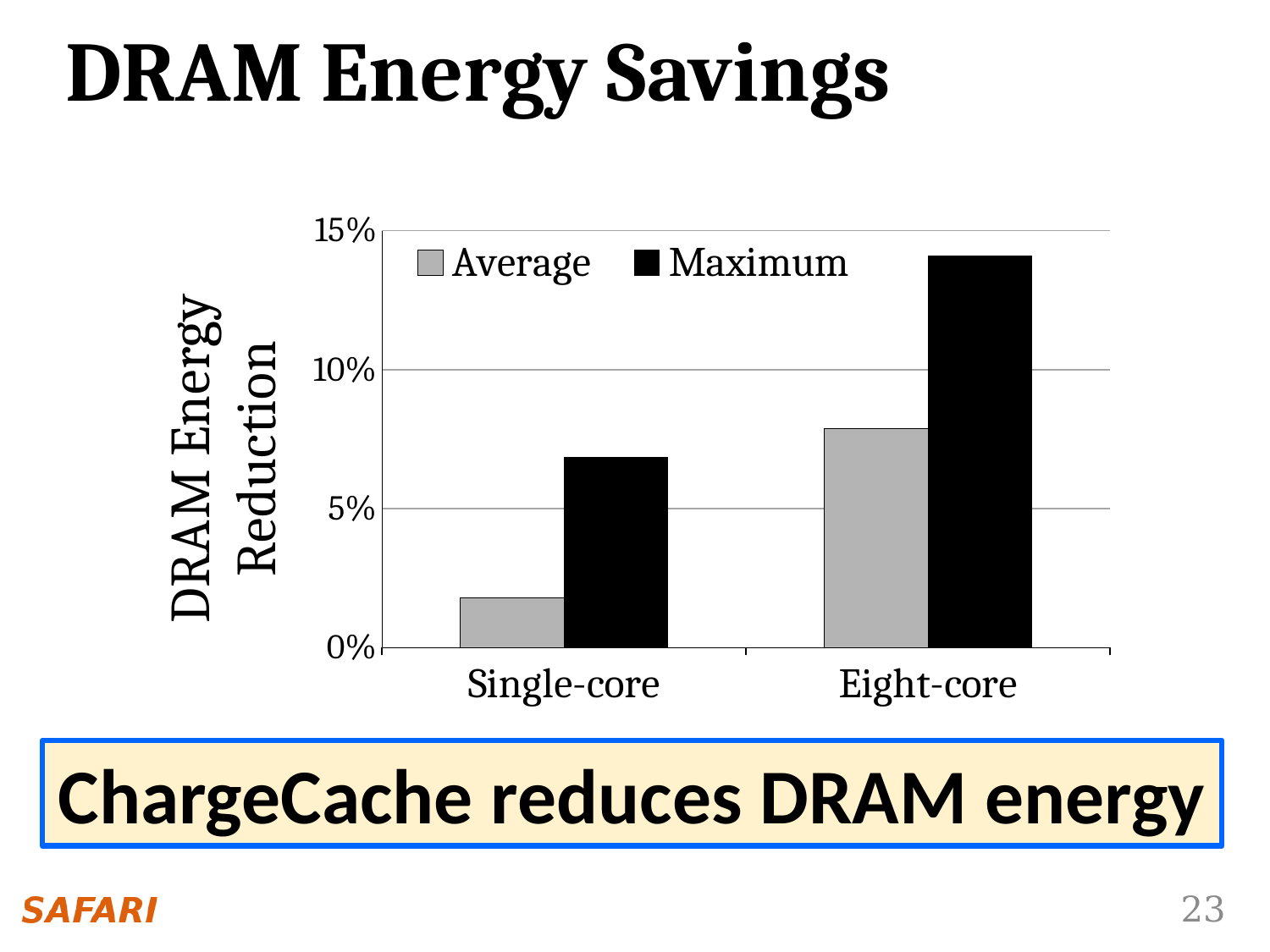
How many series does the legend list? 2 Which is larger: the Average DRAM energy reduction for Eight-core or the Maximum DRAM energy reduction for Single-core? Average for Eight-core Is the Maximum DRAM energy reduction for Single-core greater or less than 5%? greater Is the Maximum DRAM energy reduction for Eight-core greater or less than 10%? greater Which category has the lowest Average DRAM energy reduction? Single-core What is the label on the y axis of the chart? DRAM Energy Reduction Do the Average values rise or fall from Single-core to Eight-core? rise Is the Average DRAM energy reduction for Single-core greater or less than 5%? less Which category has the highest Maximum DRAM energy reduction? Eight-core What kind of chart is shown on the slide? bar chart How many categories are shown on the x axis? 2